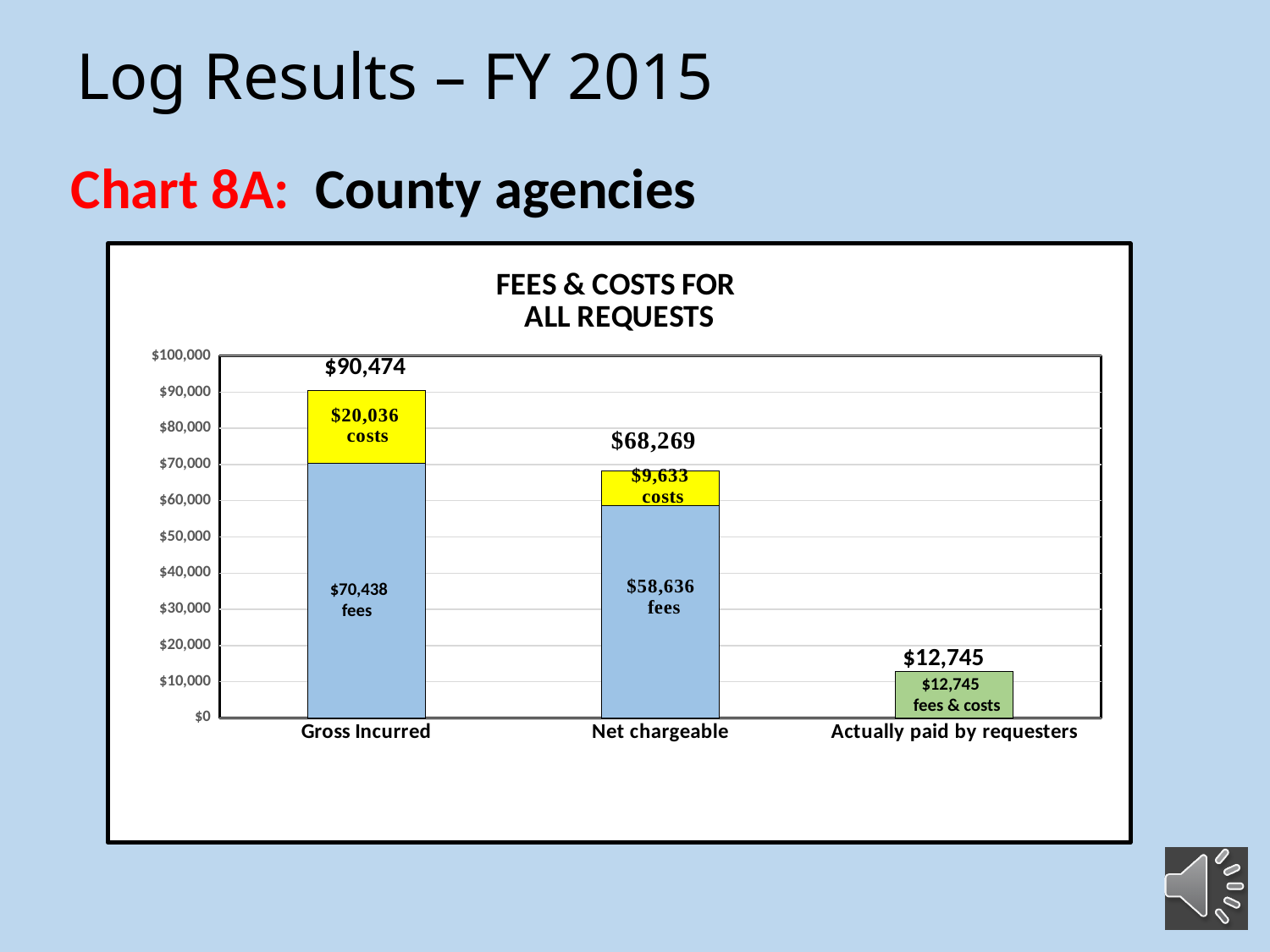
What is the title of the chart? FEES & COSTS FOR ALL REQUESTS What is the total value shown for the Gross Incurred bar? $90,474 What is the difference between the Gross Incurred total and the Net chargeable total? $22,205 What is the costs portion of the Gross Incurred bar? $20,036 What is the total value shown for the Net chargeable bar? $68,269 Which category has the highest total value? Gross Incurred What is the fees portion of the Gross Incurred bar? $70,438 What is the costs portion of the Net chargeable bar? $9,633 What is the value for Actually paid by requesters? $12,745 Which category has the lowest total value? Actually paid by requesters How many categories are shown on the x axis? 3 Which is larger, the fees portion of Gross Incurred or the fees portion of Net chargeable? Gross Incurred